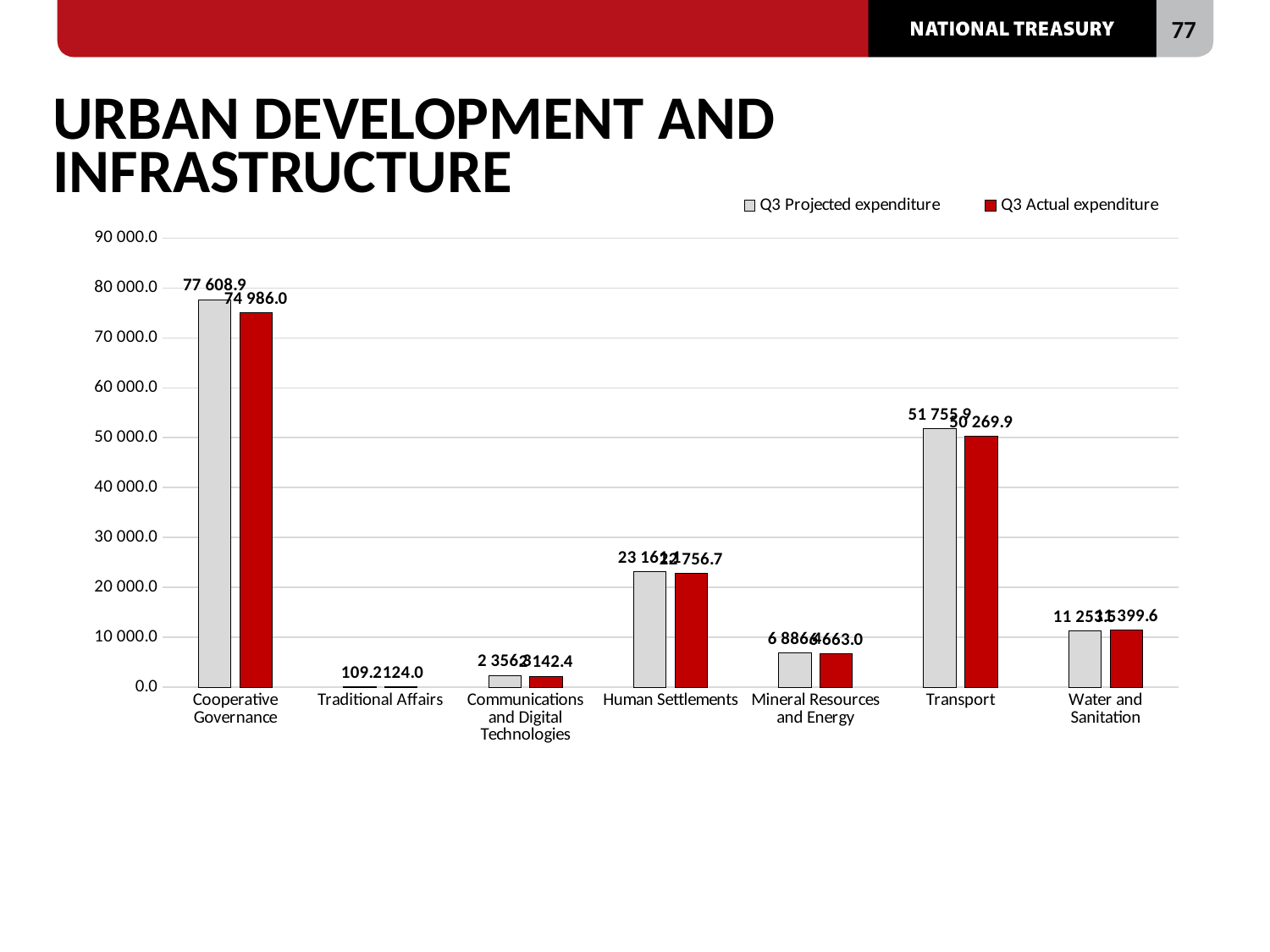
How many series does the chart legend list? 2 What is the Q3 Projected expenditure for Cooperative Governance? 77 608.9 Is the Q3 Projected expenditure for Human Settlements greater or less than 20 000.0? greater What type of chart is shown on the slide? Bar chart Which category has the lowest Q3 Actual expenditure? Traditional Affairs Which is larger: the Q3 Projected expenditure for Transport or for Human Settlements? Transport What is the Q3 Actual expenditure for Traditional Affairs? 124.0 What is the difference between the Q3 Projected and Q3 Actual expenditure for Transport? 1 486.0 What is the difference between the Q3 Projected and Q3 Actual expenditure for Cooperative Governance? 2 622.9 What is the Q3 Actual expenditure for Transport? 50 269.9 How many categories are shown on the x axis of the chart? 7 Which category has the highest Q3 Projected expenditure? Cooperative Governance